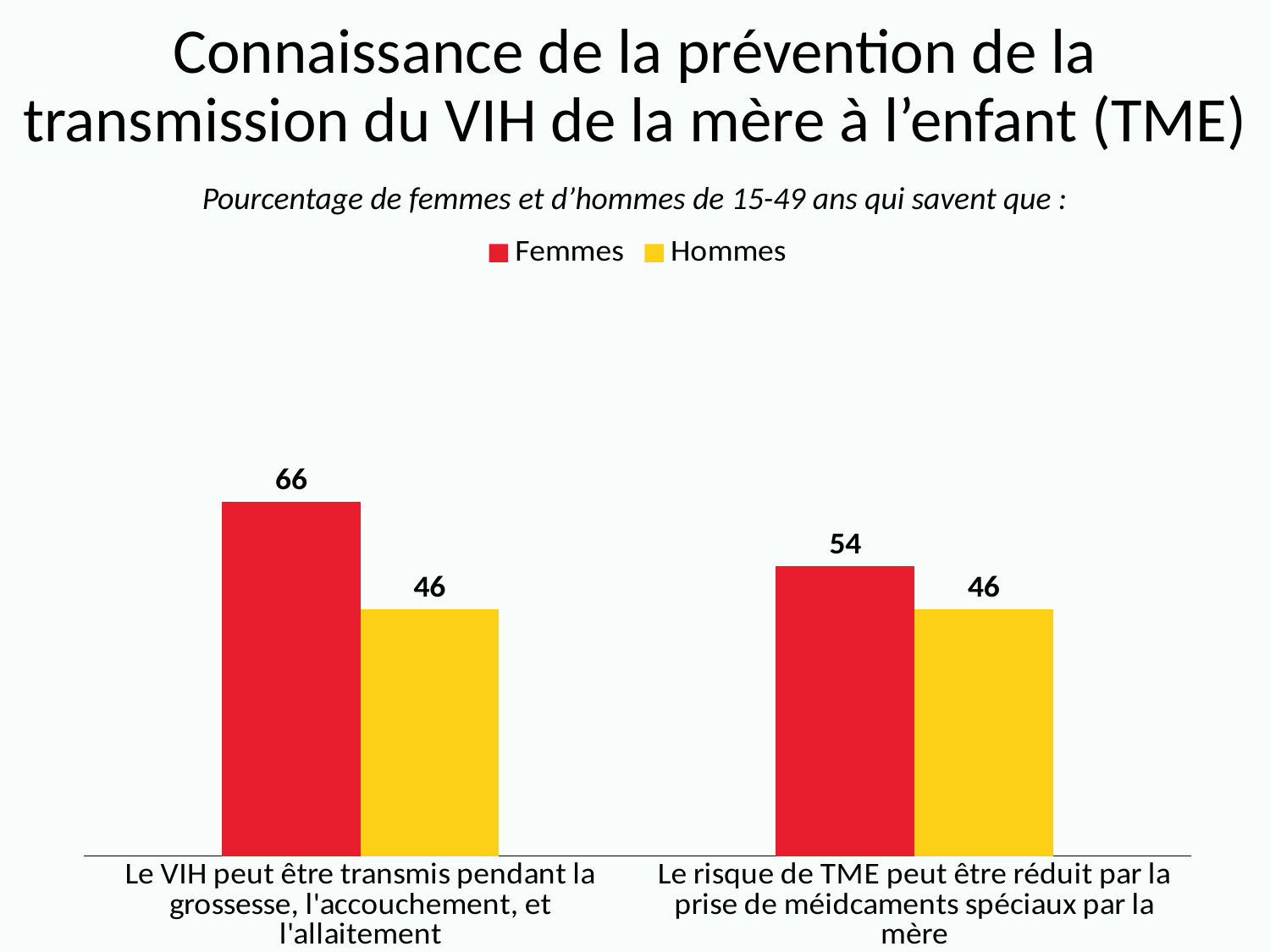
How many series does the legend list? 2 Which is larger: the Femmes value for the first category or the Femmes value for the second category? The first category (66) Which series has the highest value on the chart? Femmes What is the value for Femmes for the category 'Le risque de TME peut être réduit par la prise de méidcaments spéciaux par la mère'? 54 What kind of chart is shown on the slide? Bar chart What is the difference between the Femmes and Hommes values for the category about HIV transmission during pregnancy, delivery and breastfeeding? 20 Which colour represents Hommes in the chart? Yellow How many categories are shown on the x axis? 2 What is the value for Hommes for the category 'Le VIH peut être transmis pendant la grossesse, l'accouchement, et l'allaitement'? 46 What is the difference between the Femmes and Hommes values for the category about reducing the risk of TME with special medicines? 8 What percentage of men (Hommes) know that the risk of mother-to-child transmission can be reduced by the mother taking special medicines? 46 What percentage of women (Femmes) know that HIV can be transmitted during pregnancy, delivery and breastfeeding? 66